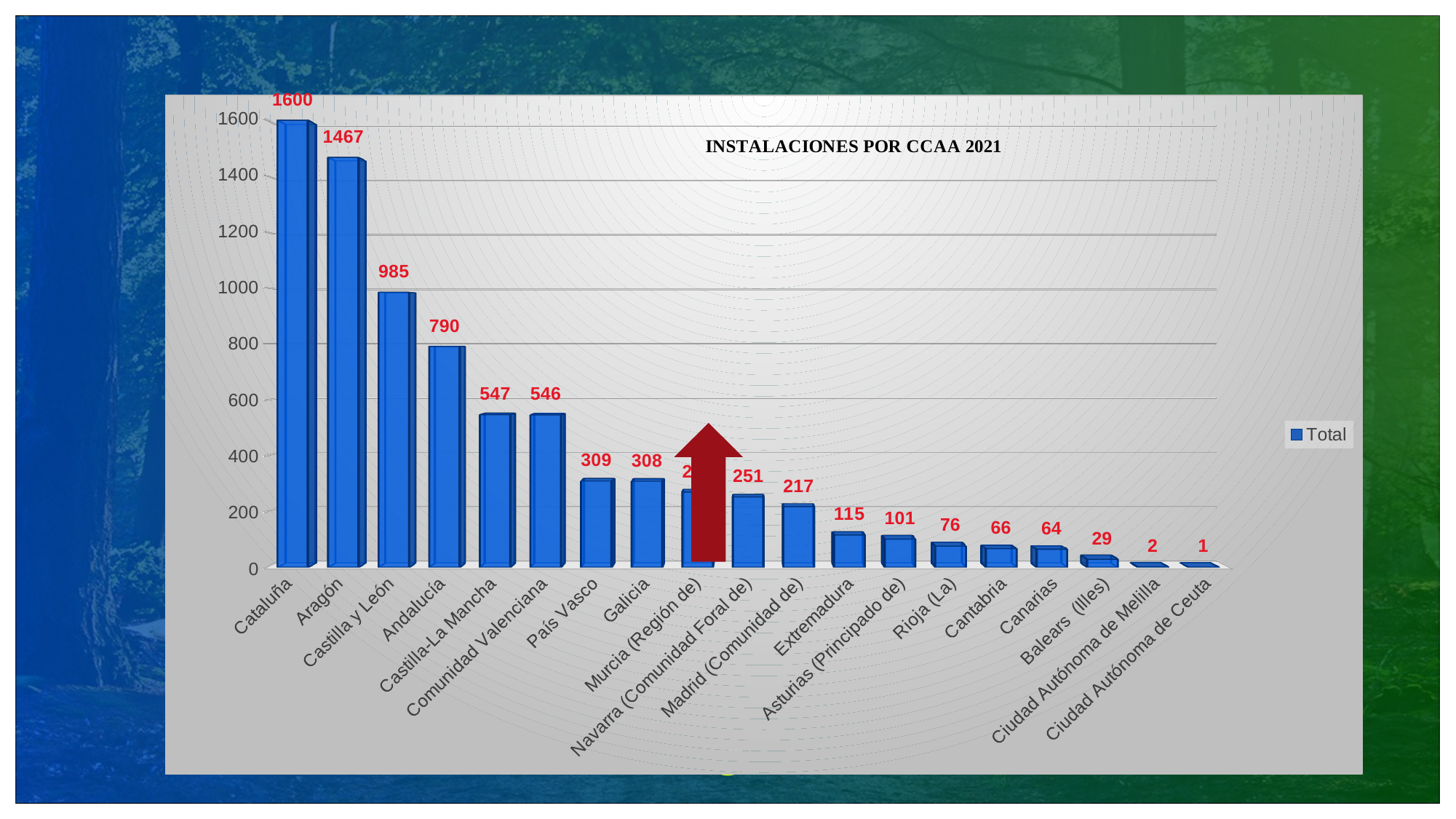
What is the value for Balears (Illes)? 29 Which category has the lowest value? Ciudad Autónoma de Ceuta What is the title of the chart? INSTALACIONES POR CCAA 2021 What is the value for Cataluña? 1600 How many categories are shown on the x axis? 19 What is the value for Castilla y León? 985 What is the difference between the values for Cataluña and Aragón? 133 Is the value for Murcia (Región de) greater or less than 400? less Which category has the highest value? Cataluña What is the value for Madrid (Comunidad de)? 217 Which is larger, the value for Andalucía or the value for Castilla-La Mancha? Andalucía How many series does the legend list? 1